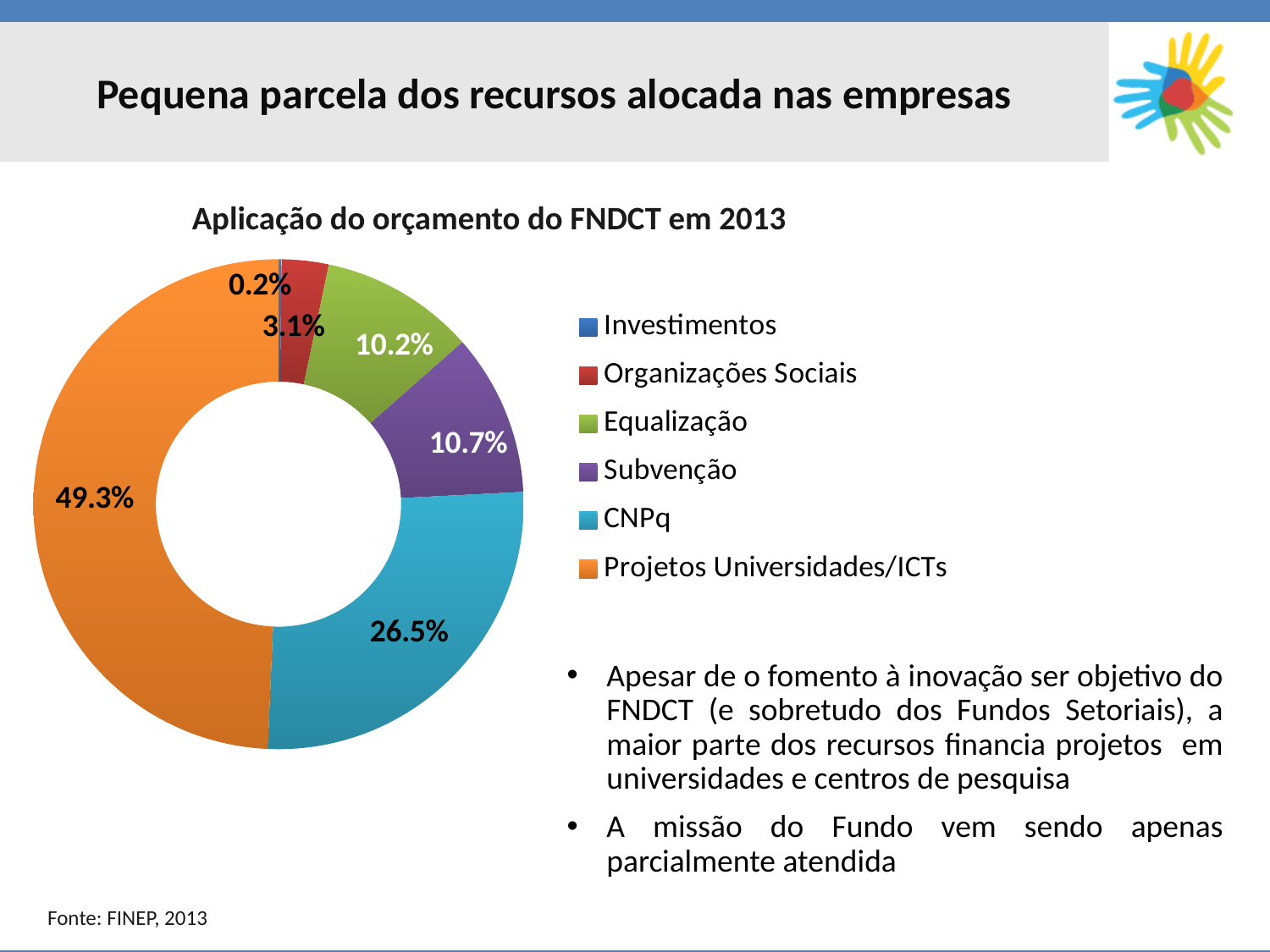
Which category has the largest share of the FNDCT 2013 budget? Projetos Universidades/ICTs How many categories does the chart show? 6 What is the value shown for Organizações Sociais? 3.1% What is the combined share of Equalização and Subvenção? 20.9% Which category has the smallest share of the budget? Investimentos What is the value shown for Subvenção? 10.7% What share of the FNDCT 2013 budget went to Projetos Universidades/ICTs? 49.3% What percentage of the budget is shown for CNPq? 26.5% What is the difference in percentage points between Projetos Universidades/ICTs and CNPq? 22.8 What type of chart is used on the slide? Doughnut chart What is the title of the chart? Aplicação do orçamento do FNDCT em 2013 Which is larger, the share for Subvenção or the share for Equalização? Subvenção